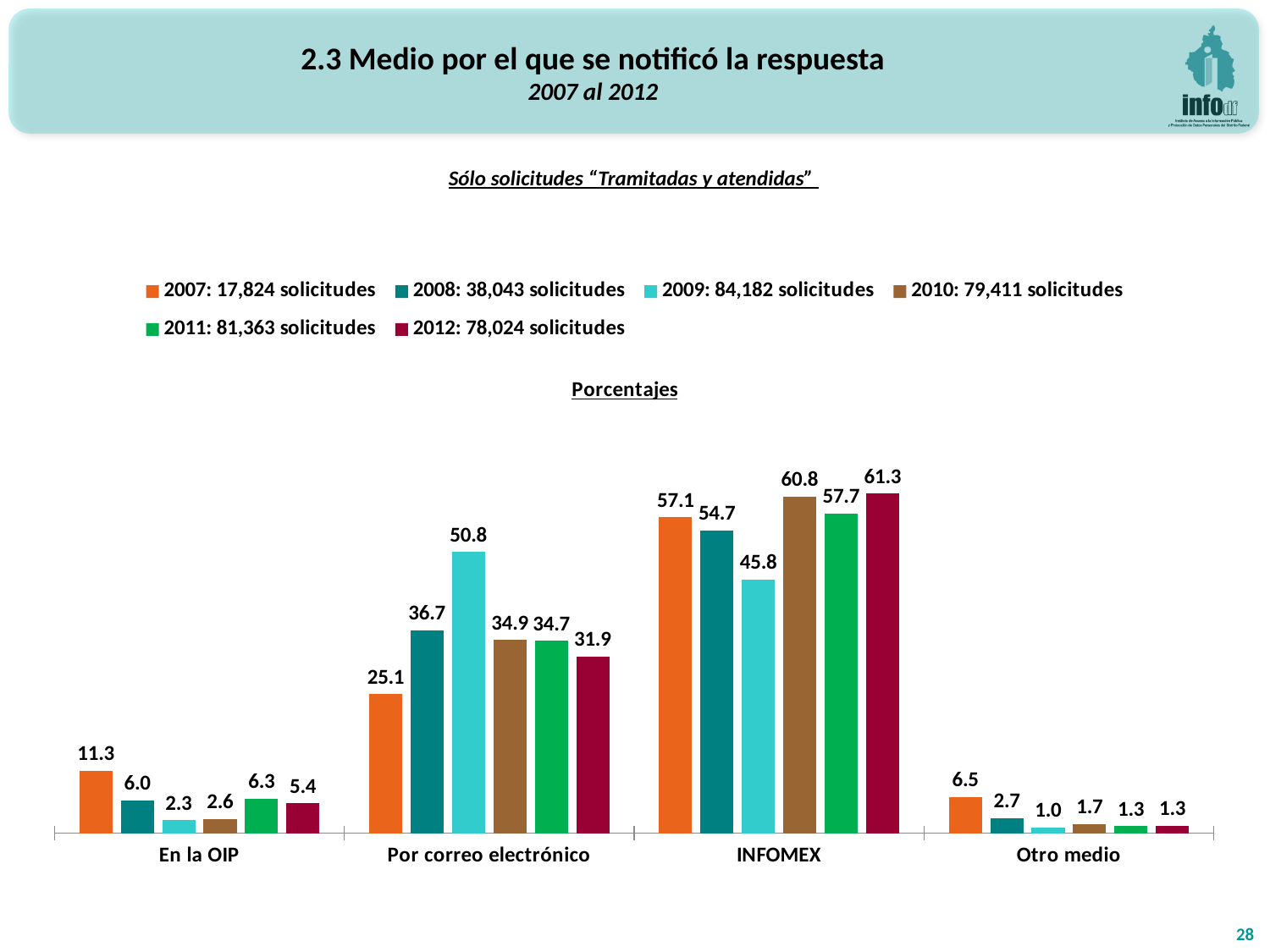
How many series does the legend list? 6 Which is larger in the 'En la OIP' category: the value for 2008 or the value for 2011? 2011 How do the values for 'Por correo electrónico' change from 2009 to 2012? They fall What is the value for 2009 in the 'Por correo electrónico' category? 50.8 According to the legend, how many solicitudes were there in 2009? 84,182 Which year has the highest value in the INFOMEX category? 2012 What is the difference between the 2009 and 2007 values in the 'Por correo electrónico' category? 25.7 What type of chart is shown on the slide? bar chart How many categories are shown on the x axis? 4 Which year has the lowest value in the 'Otro medio' category? 2009 What is the value for 2012 in the INFOMEX category? 61.3 What is the value for 2007 in the 'En la OIP' category? 11.3